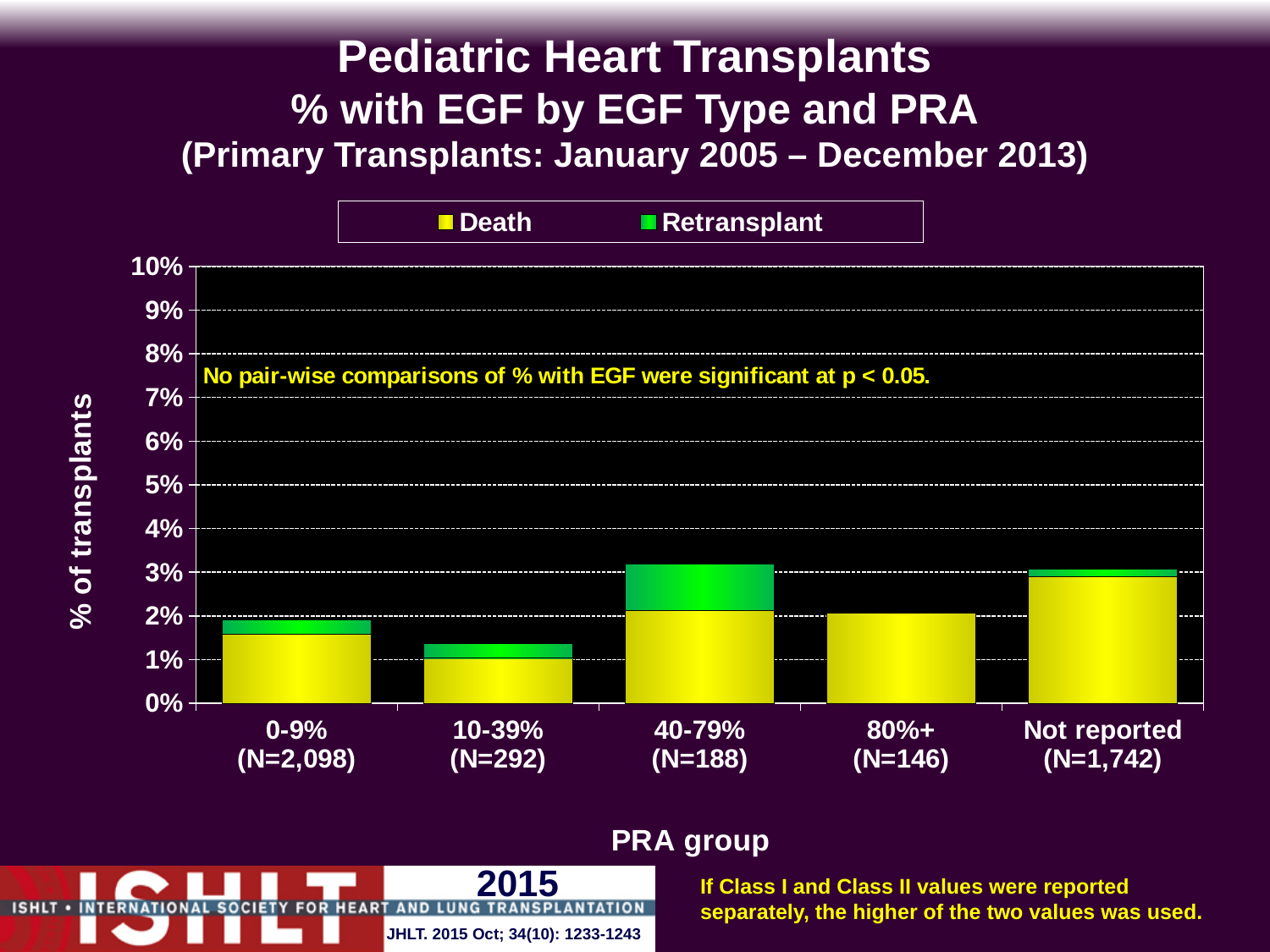
How many PRA groups are shown on the x axis? 5 Which has a larger total % with EGF, the 40-79% group or the 10-39% group? 40-79% Which PRA group has the lowest total % with EGF? 10-39% (N=292) Is the total value for the Not reported PRA group greater or less than 2%? greater Which has a larger total % with EGF, the Not reported group or the 0-9% group? Not reported What kind of chart is shown on the slide? bar chart How many series does the legend list? 2 What is the title of the y axis? % of transplants What are the two series named in the legend? Death and Retransplant Is the total value for the 10-39% PRA group greater or less than 2%? less Is the total value for the 40-79% PRA group greater or less than 3%? greater